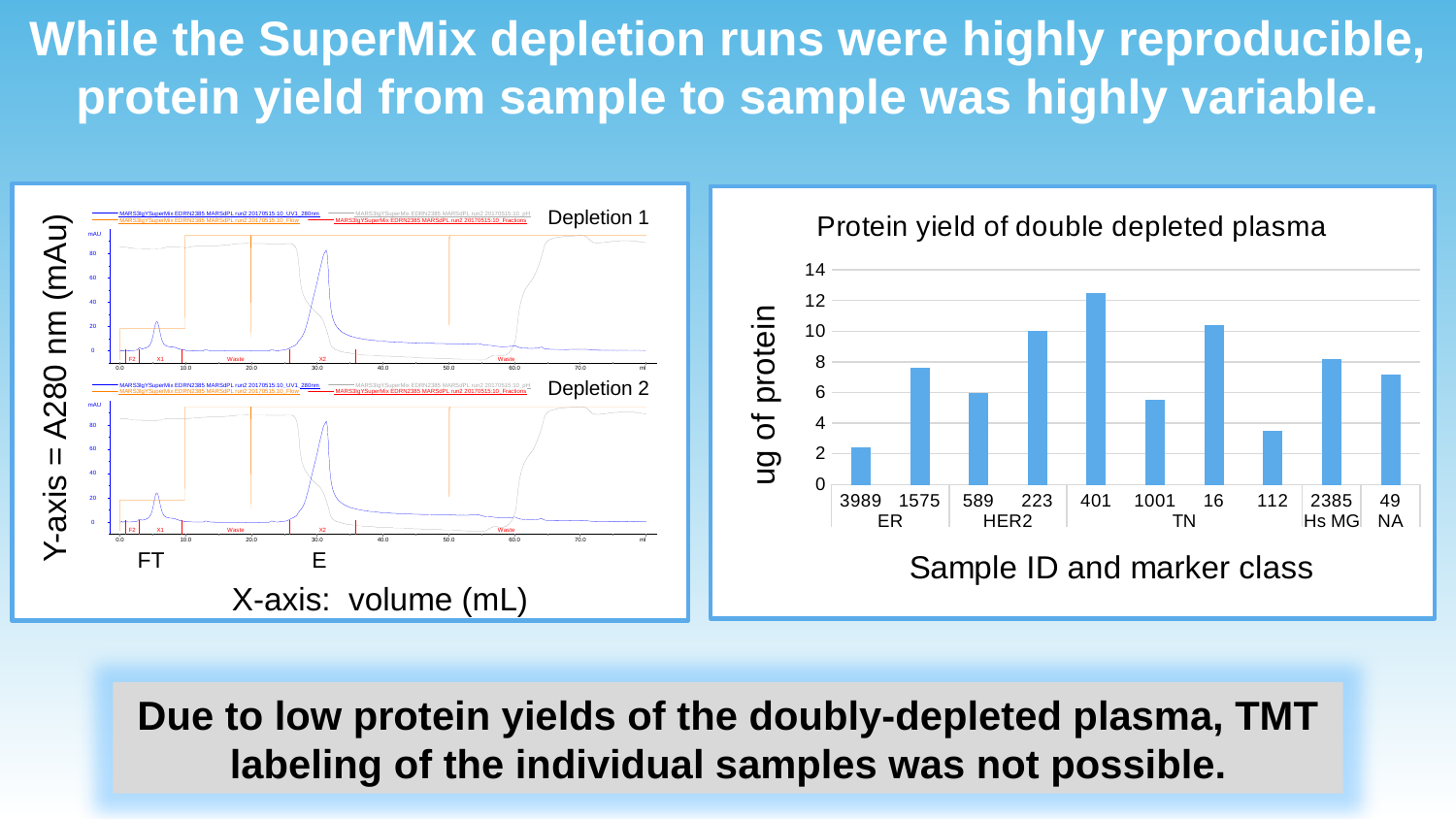
On the right-hand chart, what is the title of the chart? Protein yield of double depleted plasma On the right-hand chart, what kind of chart is it? bar chart On the right-hand chart, which has the larger protein yield, sample 1575 or sample 589? 1575 On the left-hand chart, what quantity is shown on the x-axis? volume (mL) On the right-hand chart, is the value for sample 3989 greater or less than 4? less On the right-hand chart, is the value for sample 112 greater or less than 4? less On the right-hand chart, how many sample bars are plotted? 10 On the right-hand chart, is the value for sample 223 greater or less than 8? greater On the right-hand chart, which sample ID has the lowest protein yield? 3989 On the right-hand chart, which sample ID has the highest protein yield? 401 On the right-hand chart, which has the larger protein yield, sample 223 or sample 112? 223